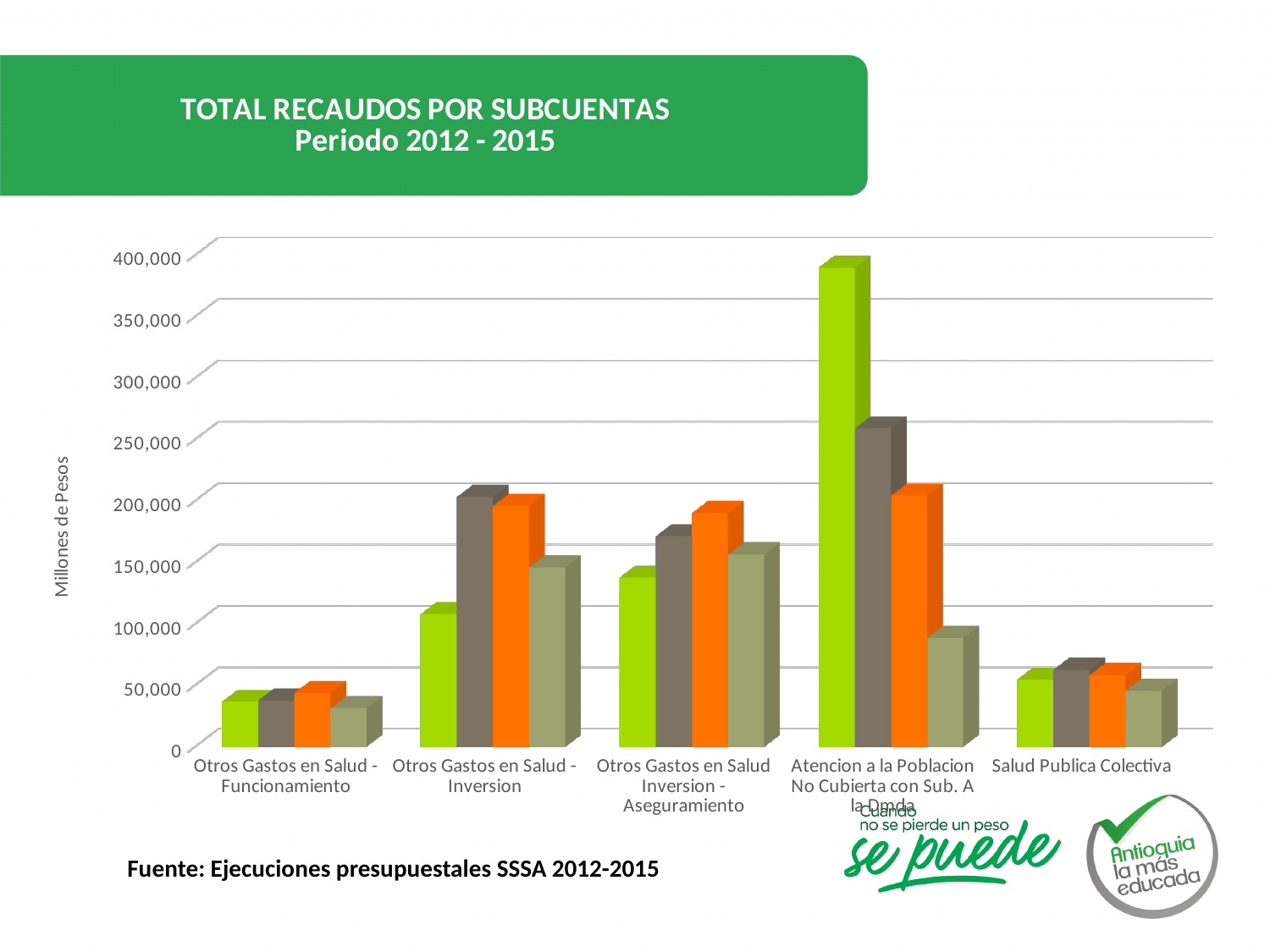
How many bars are plotted for each category in the chart? 4 What is the title of the vertical axis of the chart? Millones de Pesos How many categories are shown on the x axis of the chart? 5 What is the title of the chart? TOTAL RECAUDOS POR SUBCUENTAS Periodo 2012 - 2015 Is the light green bar for Atencion a la Poblacion No Cubierta con Sub. A la Dmda greater or less than 350,000? greater In the Atencion a la Poblacion No Cubierta con Sub. A la Dmda category, which is larger: the light green bar or the orange bar? the light green bar Which category contains the tallest bar in the chart? Atencion a la Poblacion No Cubierta con Sub. A la Dmda Which category has the lowest bars overall in the chart? Otros Gastos en Salud - Funcionamiento Is the tan bar for Atencion a la Poblacion No Cubierta con Sub. A la Dmda greater or less than 100,000? less Is the light green bar for Otros Gastos en Salud - Inversion greater or less than 150,000? less What kind of chart is shown on the slide? bar chart